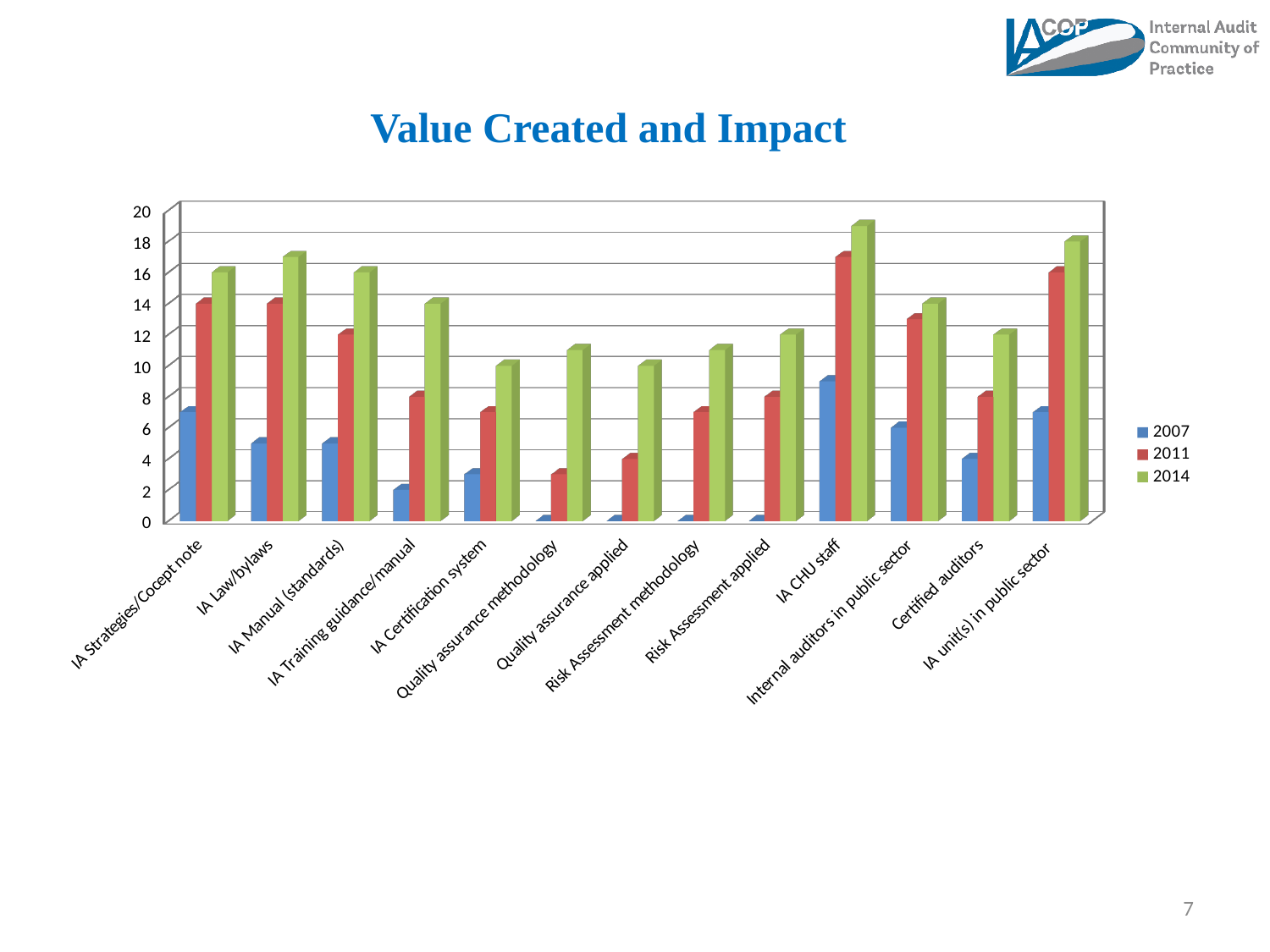
Is the 2011 value for Quality assurance methodology greater or less than 6? less What kind of chart is shown on the slide? bar chart How many categories are shown along the x axis? 13 Which years are listed in the chart legend? 2007, 2011, 2014 Is the 2014 value for IA Law/bylaws greater or less than 14? greater For 2007, which is larger: IA CHU staff or IA Certification system? IA CHU staff How many series does the legend list? 3 Which category has the highest 2007 value? IA CHU staff For IA Law/bylaws, do the values rise or fall from 2007 to 2014? rise Is the 2007 value for IA Training guidance/manual greater or less than 4? less What is the title of the chart? Value Created and Impact